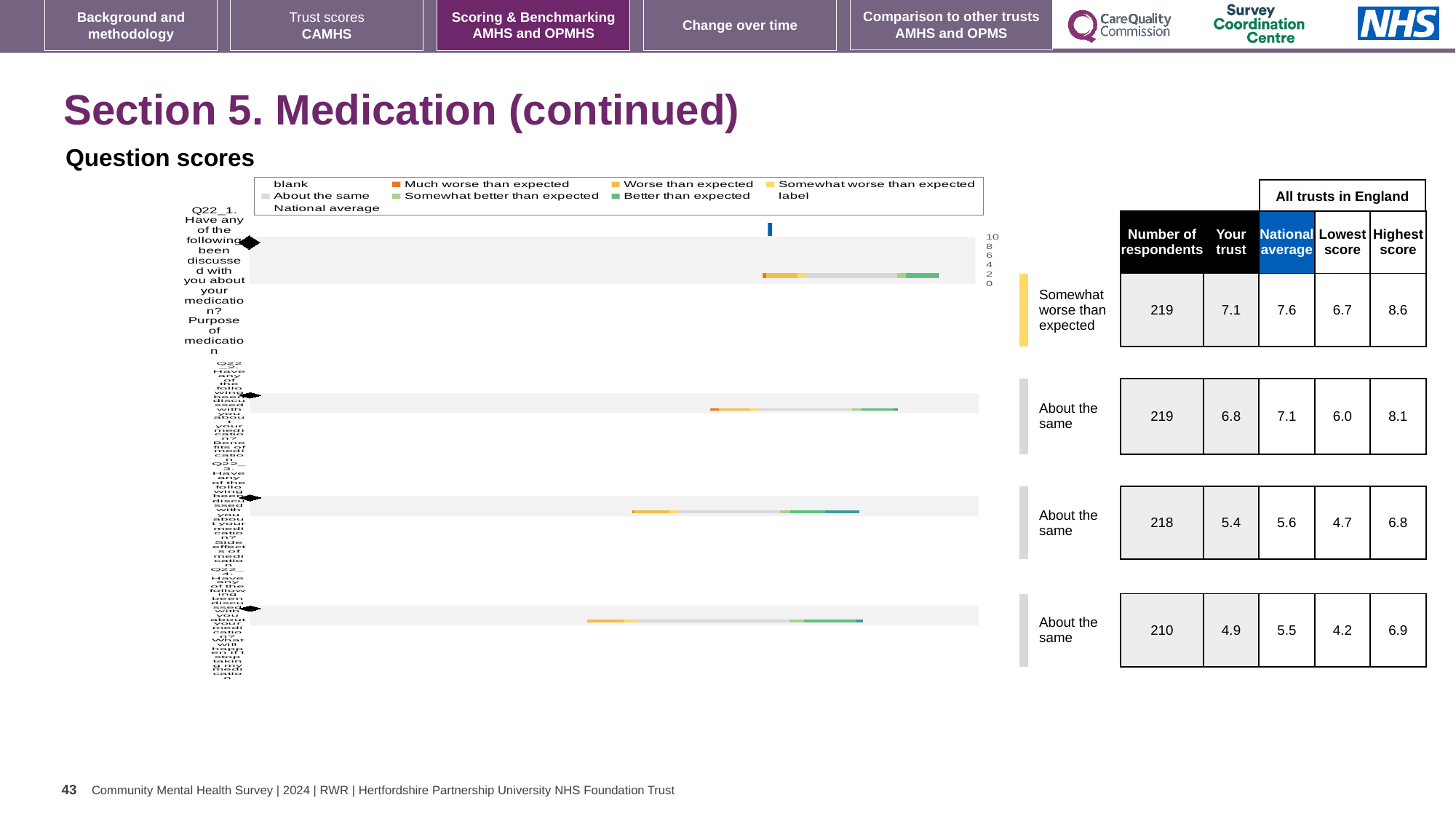
What is the highest tick value shown on the chart's score axis? 10 In the table beside the chart, is the 'Your trust' score for the second row (Q22_2) larger or smaller than the national average? smaller In the table beside the chart, which row has the lowest 'Your trust' score? Q22_4 (4.9) How many question bars (Q22_1 to Q22_4) are plotted in the chart? 4 In the table beside the chart, what is the difference between the national average and 'Your trust' score for the third row (Q22_3, Side effects of medication)? 0.2 What kind of chart is shown under 'Question scores'? bar chart In the table beside the chart, what is the 'Your trust' score for the first row (Q22_1, Purpose of medication)? 7.1 How many of the four questions in the chart are rated 'About the same'? 3 Which question in the chart is rated 'Somewhat worse than expected'? Q22_1 In the table beside the chart, what is the national average for the fourth row (Q22_4, What will happen if I stop taking my medication)? 5.5 In the table beside the chart, how many respondents answered the fourth question (Q22_4)? 210 What colour does the legend use for 'Much worse than expected'? orange